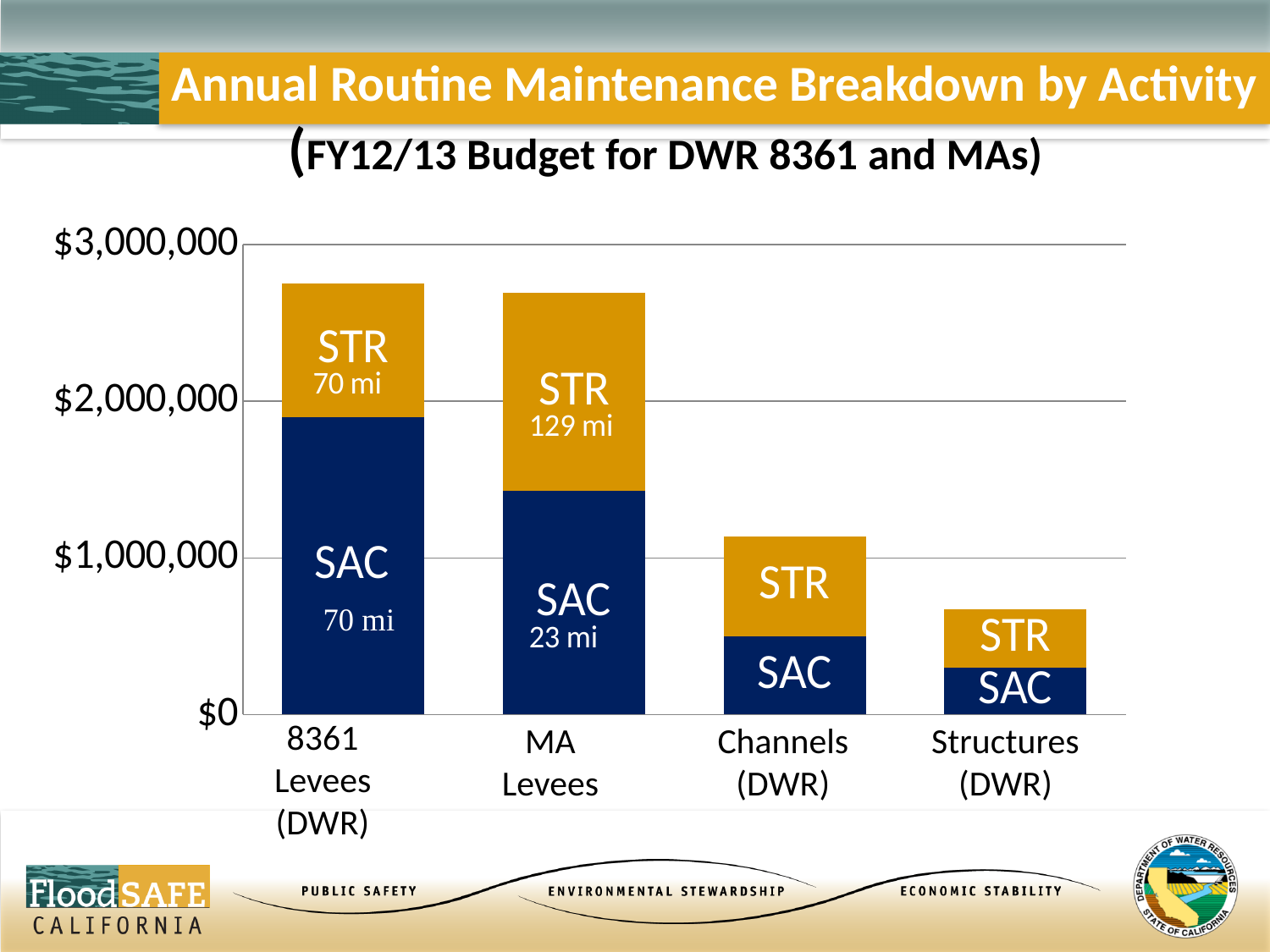
How many categories are shown on the x axis of the chart? 4 Which has the larger SAC segment, 8361 Levees (DWR) or MA Levees? 8361 Levees (DWR) Is the SAC segment for MA Levees greater or less than $1,000,000? greater What kind of chart is shown on the slide? stacked bar chart Is the total value for 8361 Levees (DWR) greater or less than $2,000,000? greater Which category has the highest total bar in the chart? 8361 Levees (DWR) What is the subtitle shown below the chart's main title? (FY12/13 Budget for DWR 8361 and MAs) Do the total bar heights rise or fall moving from left to right along the x axis? fall Which category has the lowest total bar in the chart? Structures (DWR) Which has the larger STR segment, 8361 Levees (DWR) or MA Levees? MA Levees How many miles are noted for the STR segment of MA Levees? 129 mi Is the total value for Structures (DWR) greater or less than $1,000,000? less